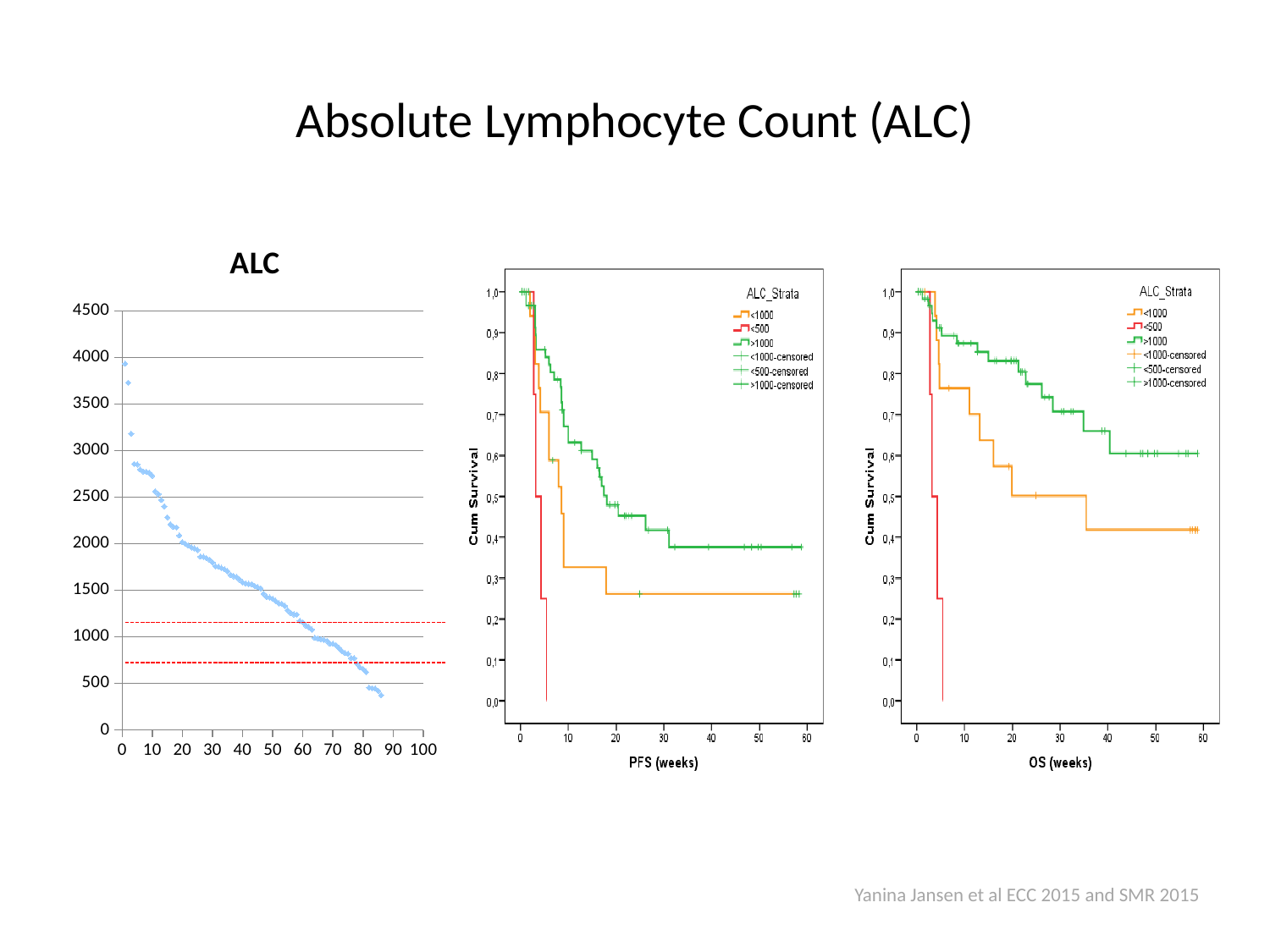
In the left chart titled "ALC", do the plotted values rise or fall as the x axis increases? fall In the right chart (OS), which stratum has higher cumulative survival at 30 weeks, >1000 or <1000? >1000 What kind of chart is the left chart titled "ALC"? scatter chart In the middle chart, what is the label of the x axis? PFS (weeks) In the left chart titled "ALC", what is the highest tick value shown on the y axis? 4500 In the right chart (OS), is the cumulative survival of the <1000 stratum at 50 weeks greater or less than 0,5? less In the left chart titled "ALC", is the lowest plotted value greater or less than 500? less In the middle chart (PFS), is the cumulative survival of the >1000 stratum at 50 weeks greater or less than 0,3? greater In the middle chart (PFS), how many ALC strata are plotted as survival curves? 3 In the middle chart (PFS), which ALC stratum has the highest cumulative survival at 40 weeks? >1000 In the middle chart (PFS), which ALC stratum has the lowest cumulative survival at 10 weeks? <500